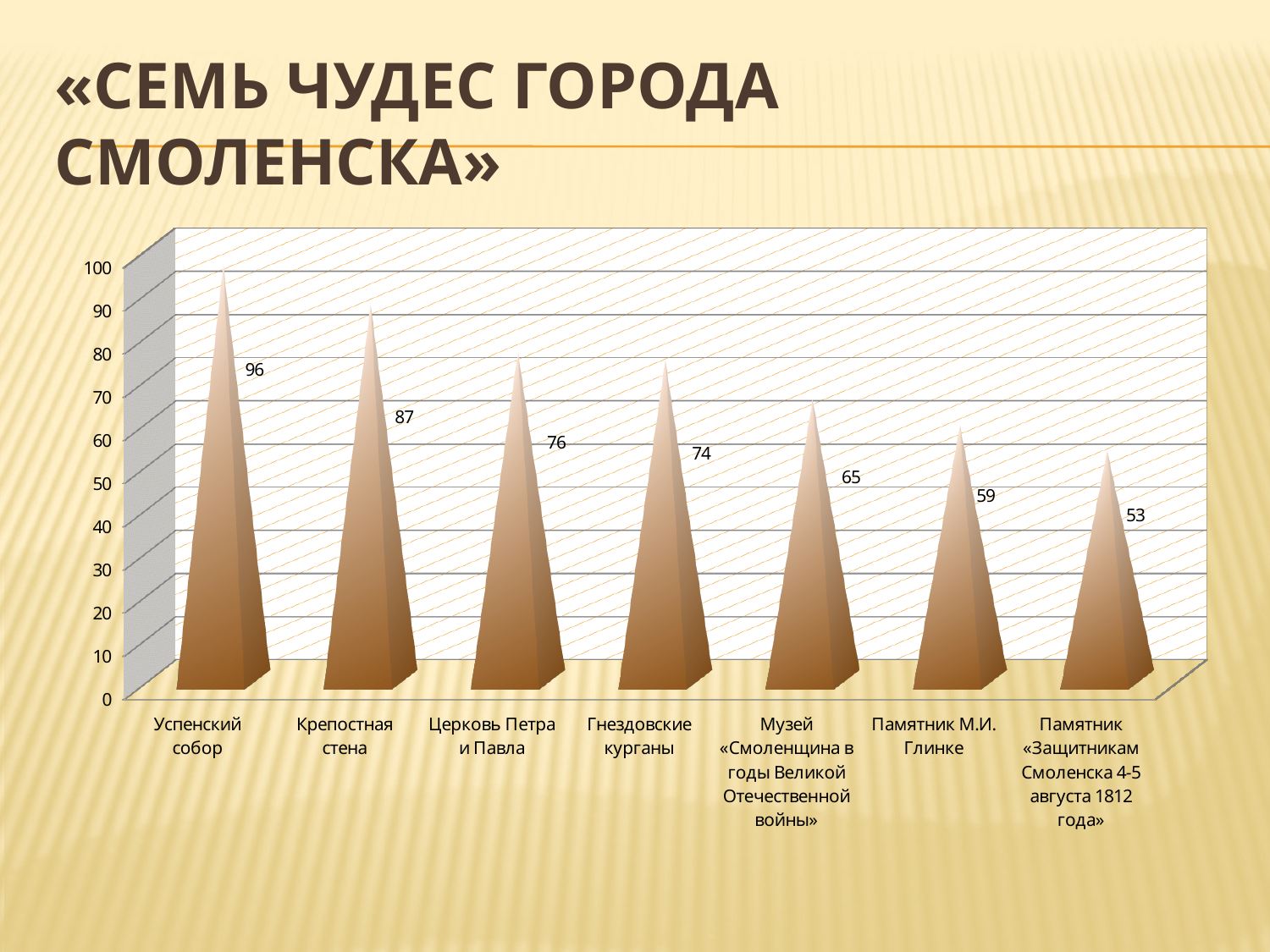
What is the value for Гнездовские курганы? 74 Is the value for Крепостная стена greater or less than 80? greater What is the difference between the values for Успенский собор and Памятник «Защитникам Смоленска 4-5 августа 1812 года»? 43 What kind of chart is shown on the slide? bar chart Which category has the lowest value? Памятник «Защитникам Смоленска 4-5 августа 1812 года» What is the difference between the values for Крепостная стена and Церковь Петра и Павла? 11 Do the values rise or fall from left to right along the x axis? fall Which category has the highest value? Успенский собор Which is larger, the value for Музей «Смоленщина в годы Великой Отечественной войны» or the value for Памятник М.И. Глинке? Музей «Смоленщина в годы Великой Отечественной войны» What is the value for Успенский собор? 96 How many categories are shown on the x axis? 7 What is the value for Памятник М.И. Глинке? 59